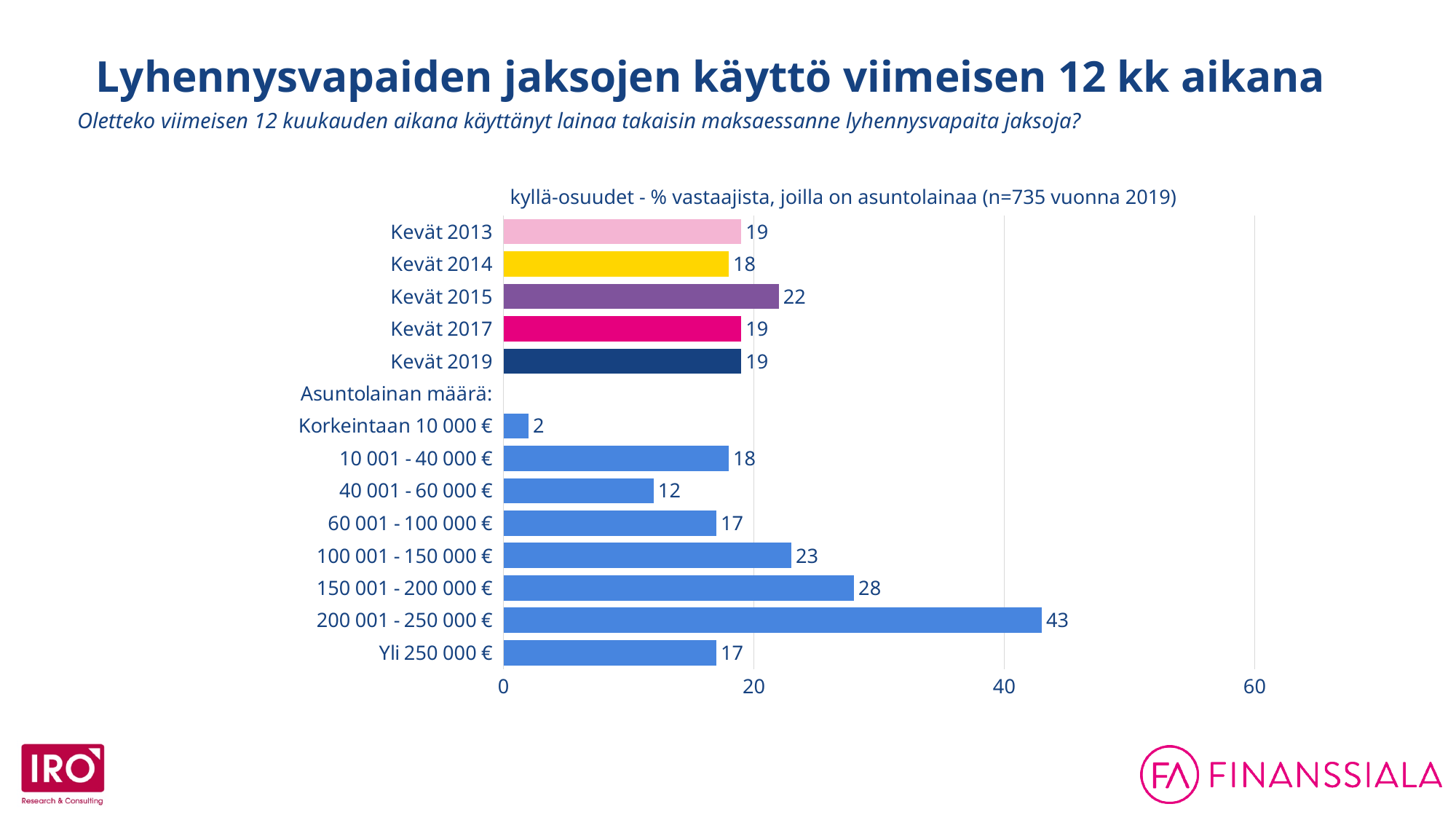
Is the value for 150 001 - 200 000 € greater or less than 20? greater What is the value for Korkeintaan 10 000 €? 2 What is the value for Kevät 2015? 22 What kind of chart is shown on the slide? bar chart How many loan amount (Asuntolainan määrä) categories have bars in the chart? 8 Which category has the lowest value in the chart? Korkeintaan 10 000 € Which category has the highest value in the chart? 200 001 - 250 000 € What is the subtitle printed above the chart? kyllä-osuudet - % vastaajista, joilla on asuntolainaa (n=735 vuonna 2019) What is the difference between the values for 200 001 - 250 000 € and 150 001 - 200 000 €? 15 What is the value for Kevät 2019? 19 What is the value for the loan amount group 200 001 - 250 000 €? 43 Which is larger, the value for 100 001 - 150 000 € or the value for 40 001 - 60 000 €? 100 001 - 150 000 €